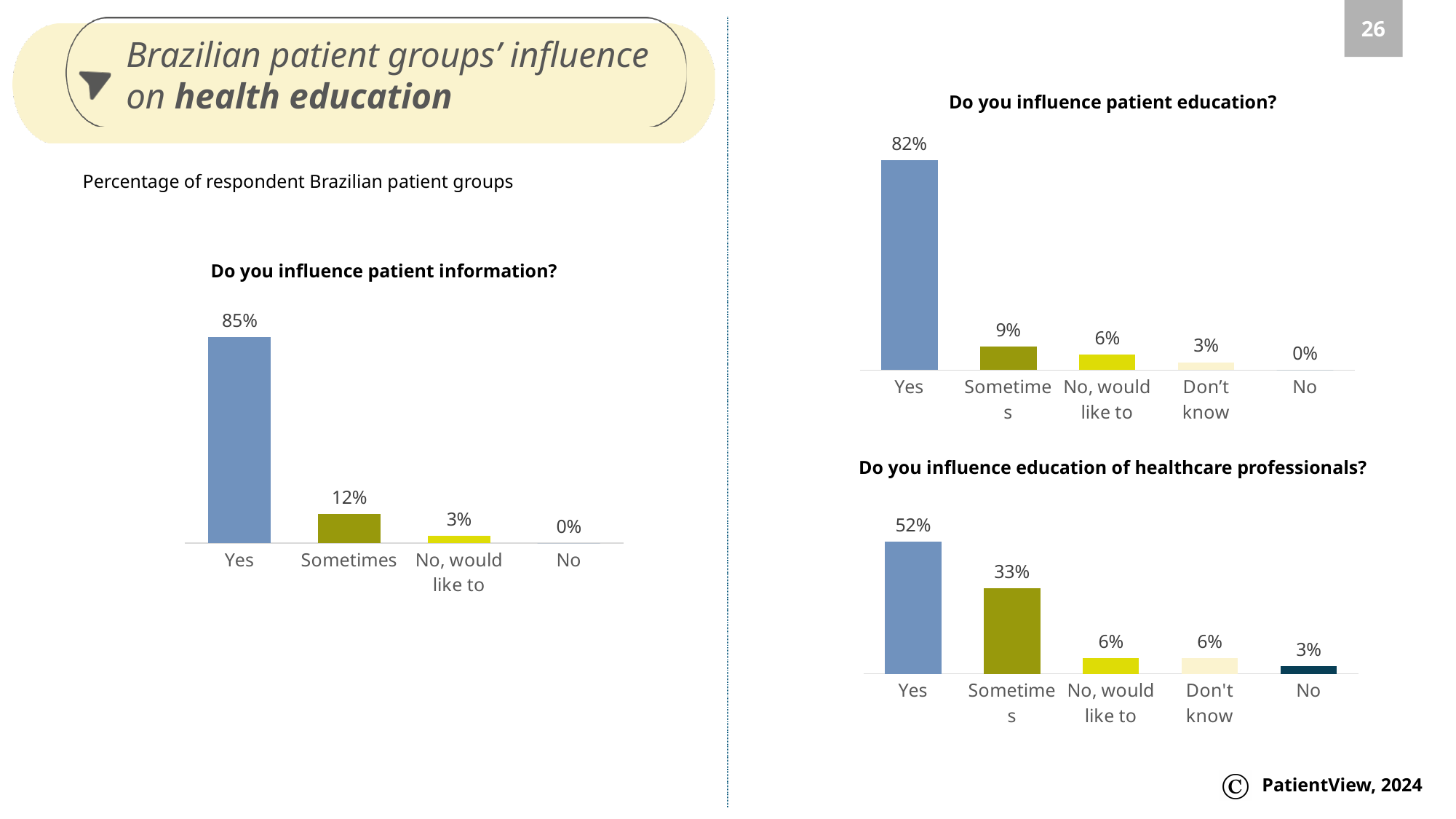
In the chart titled "Do you influence education of healthcare professionals?", what is the difference between the values for Yes and Sometimes? 19% In the chart titled "Do you influence patient education?", which is larger, the value for Sometimes or the value for Don't know? Sometimes What kind of chart is the chart titled "Do you influence patient education?"? Bar chart In the chart titled "Do you influence patient education?", which category has the lowest value? No In the chart titled "Do you influence education of healthcare professionals?", which category has the highest value? Yes In the chart titled "Do you influence patient information?", what is the value for Yes? 85% How many categories are shown in the chart titled "Do you influence education of healthcare professionals?"? 5 In the chart titled "Do you influence education of healthcare professionals?", what is the value for Sometimes? 33% In the chart titled "Do you influence patient education?", what is the value for No, would like to? 6% In the chart titled "Do you influence patient information?", what is the value for Sometimes? 12% In the chart titled "Do you influence patient information?", what is the difference between the values for Yes and Sometimes? 73% How many categories are shown in the chart titled "Do you influence patient information?"? 4